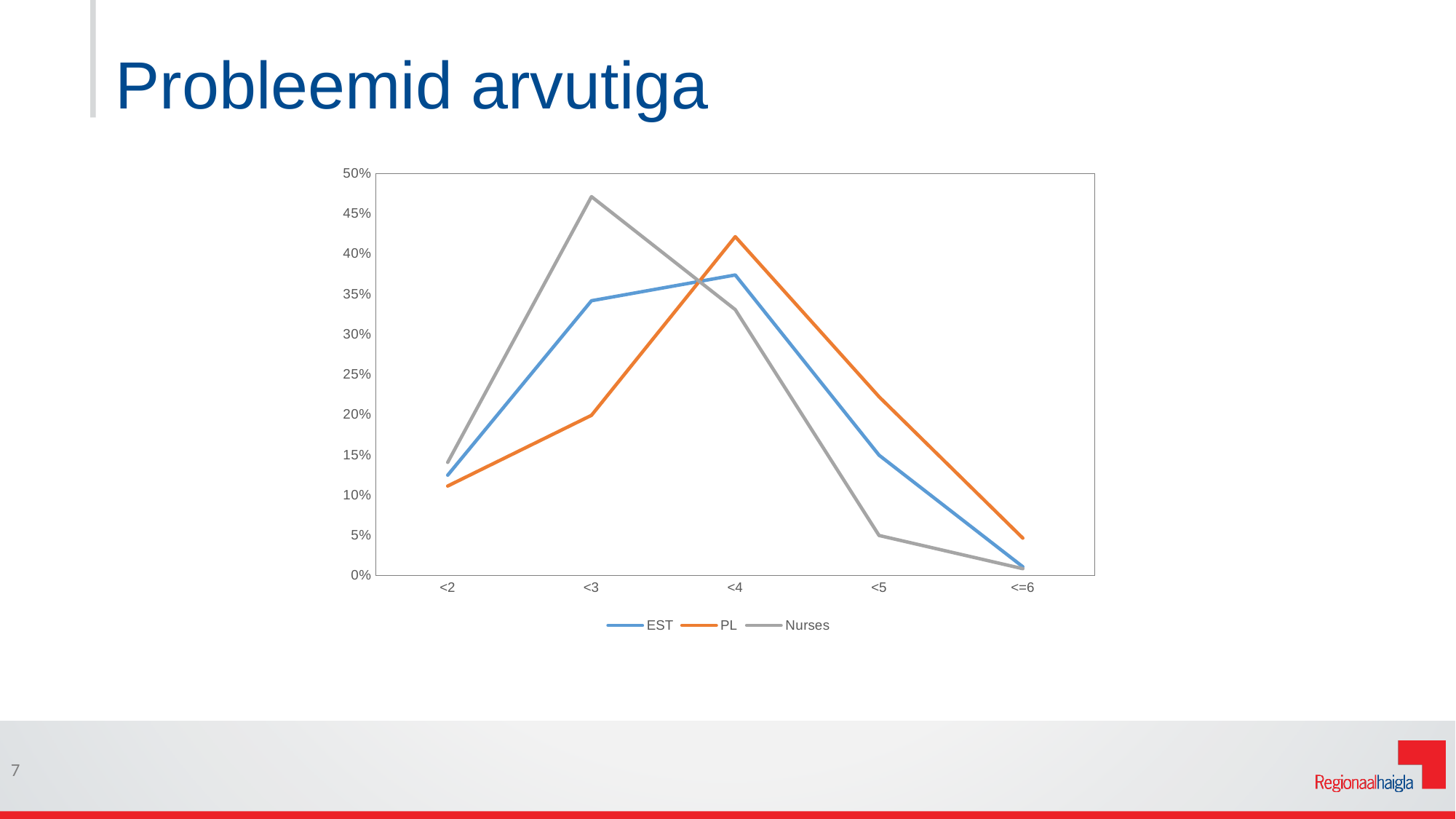
How many categories are on the x axis? 5 Is the value for EST at <5 greater or less than 10%? greater What kind of chart is shown on the slide? line chart At which category does the Nurses series reach its highest value? <3 Do the values of the PL series rise or fall from <4 to <=6? fall At which category does the PL series reach its highest value? <4 Is the value for PL at <3 greater or less than 25%? less Which series has the higher value at <5, PL or Nurses? PL Is the value for Nurses at <3 greater or less than 45%? greater At which category does the EST series reach its highest value? <4 How many series does the legend list? 3 What is the title of the slide containing the chart? Probleemid arvutiga